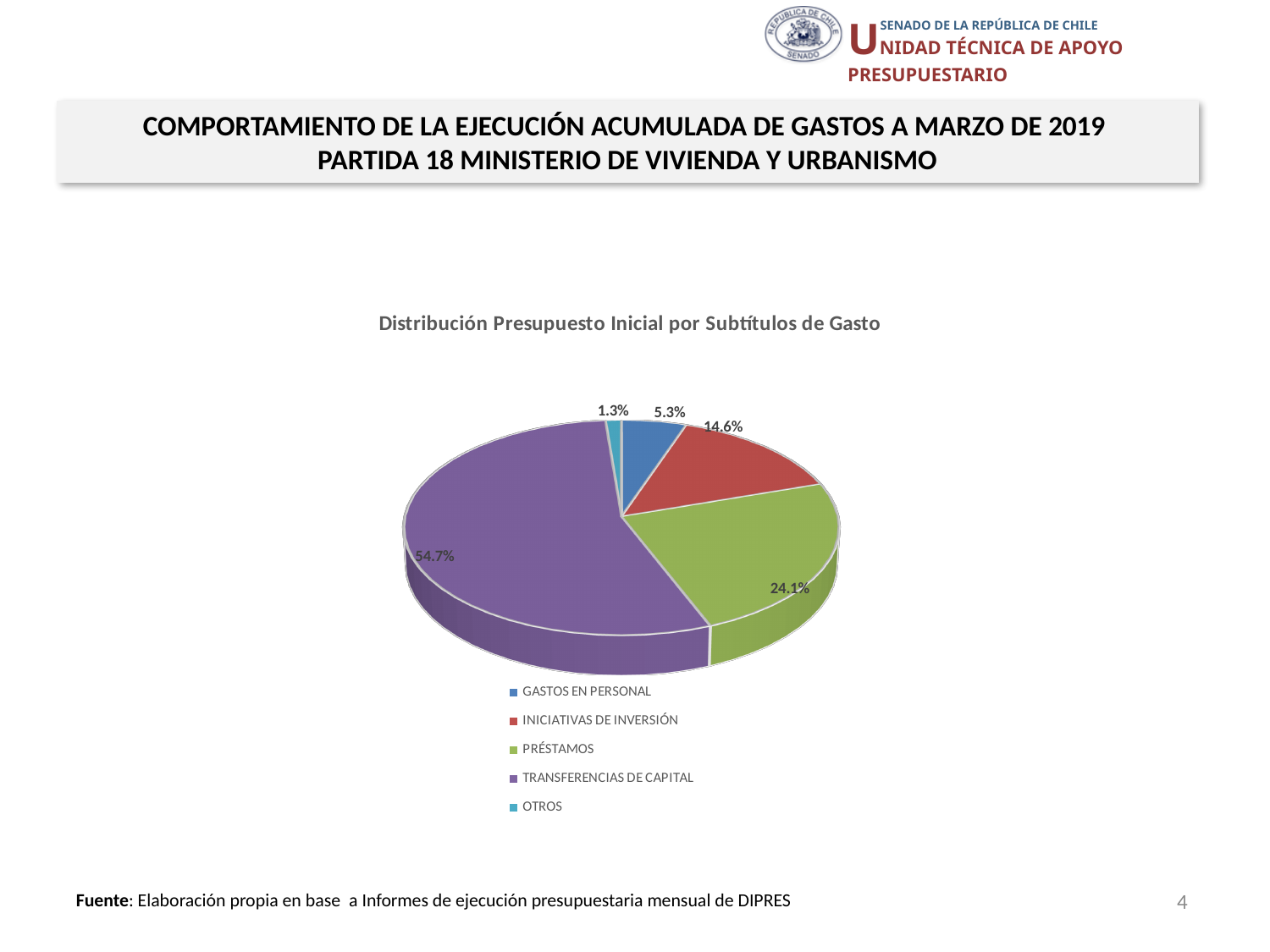
Which is larger, the share for INICIATIVAS DE INVERSIÓN or the share for GASTOS EN PERSONAL? INICIATIVAS DE INVERSIÓN What kind of chart is shown on the slide? pie chart What is the title of the chart? Distribución Presupuesto Inicial por Subtítulos de Gasto What share of the pie does TRANSFERENCIAS DE CAPITAL represent? 54.7% Which category has the smallest slice of the pie? OTROS How many categories does the legend list? 5 What share of the pie does GASTOS EN PERSONAL represent? 5.3% What share of the pie does PRÉSTAMOS represent? 24.1% What is the difference in percentage points between TRANSFERENCIAS DE CAPITAL and PRÉSTAMOS? 30.6 Which category has the largest slice of the pie? TRANSFERENCIAS DE CAPITAL